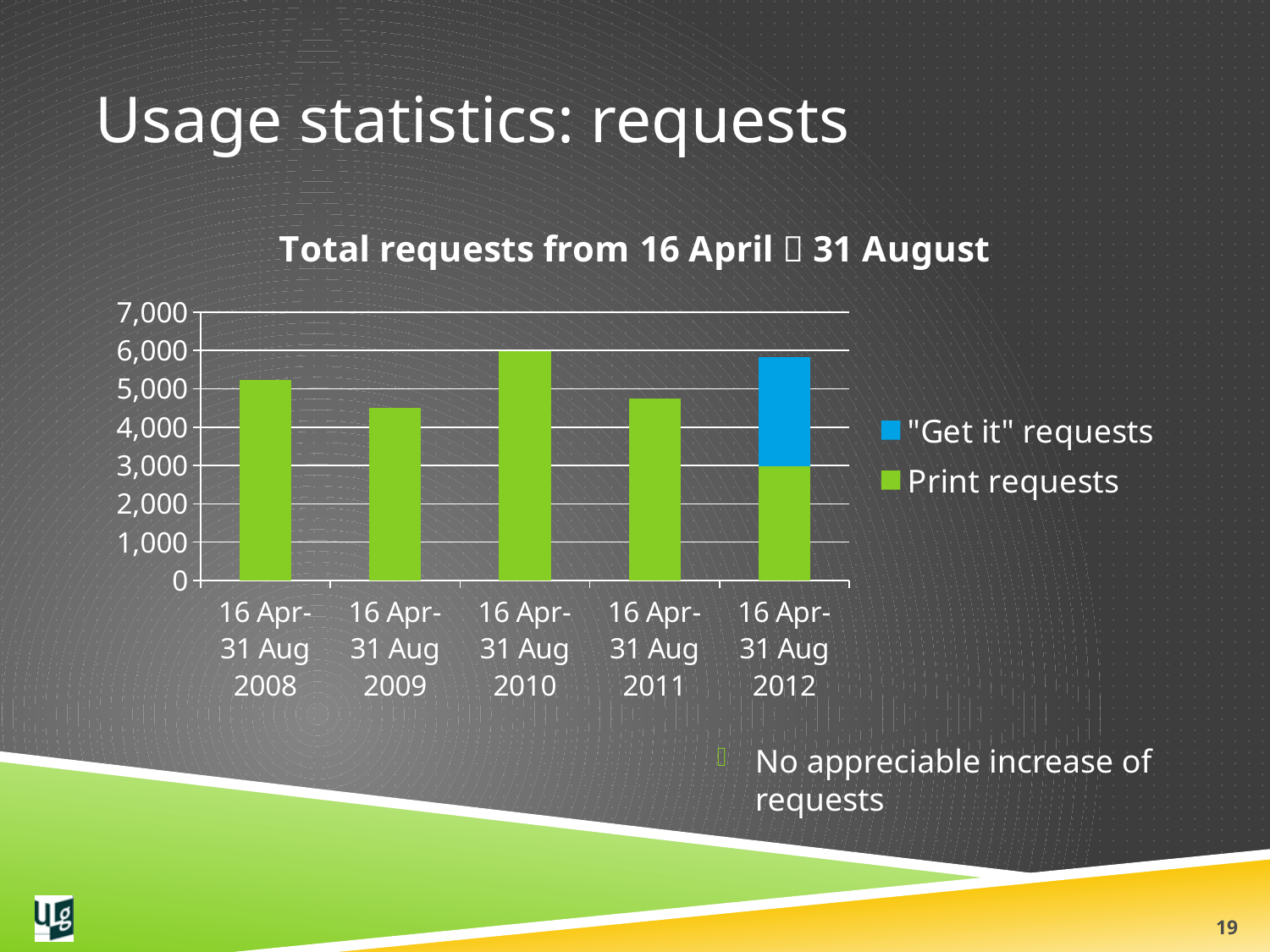
What is the title of the chart? Total requests from 16 April – 31 August How many time periods (categories) are shown on the x axis? 5 Is the value for 16 Apr-31 Aug 2008 greater or less than 5,000? greater Which has more total requests, 16 Apr-31 Aug 2008 or 16 Apr-31 Aug 2009? 16 Apr-31 Aug 2008 What kind of chart is shown on the slide? bar chart How many series does the legend list? 2 Is the value for 16 Apr-31 Aug 2011 greater or less than 5,000? less Is the total value for 16 Apr-31 Aug 2010 greater or less than 5,000? greater Which has more total requests, 16 Apr-31 Aug 2010 or 16 Apr-31 Aug 2011? 16 Apr-31 Aug 2010 Which colour represents "Get it" requests in the legend? blue